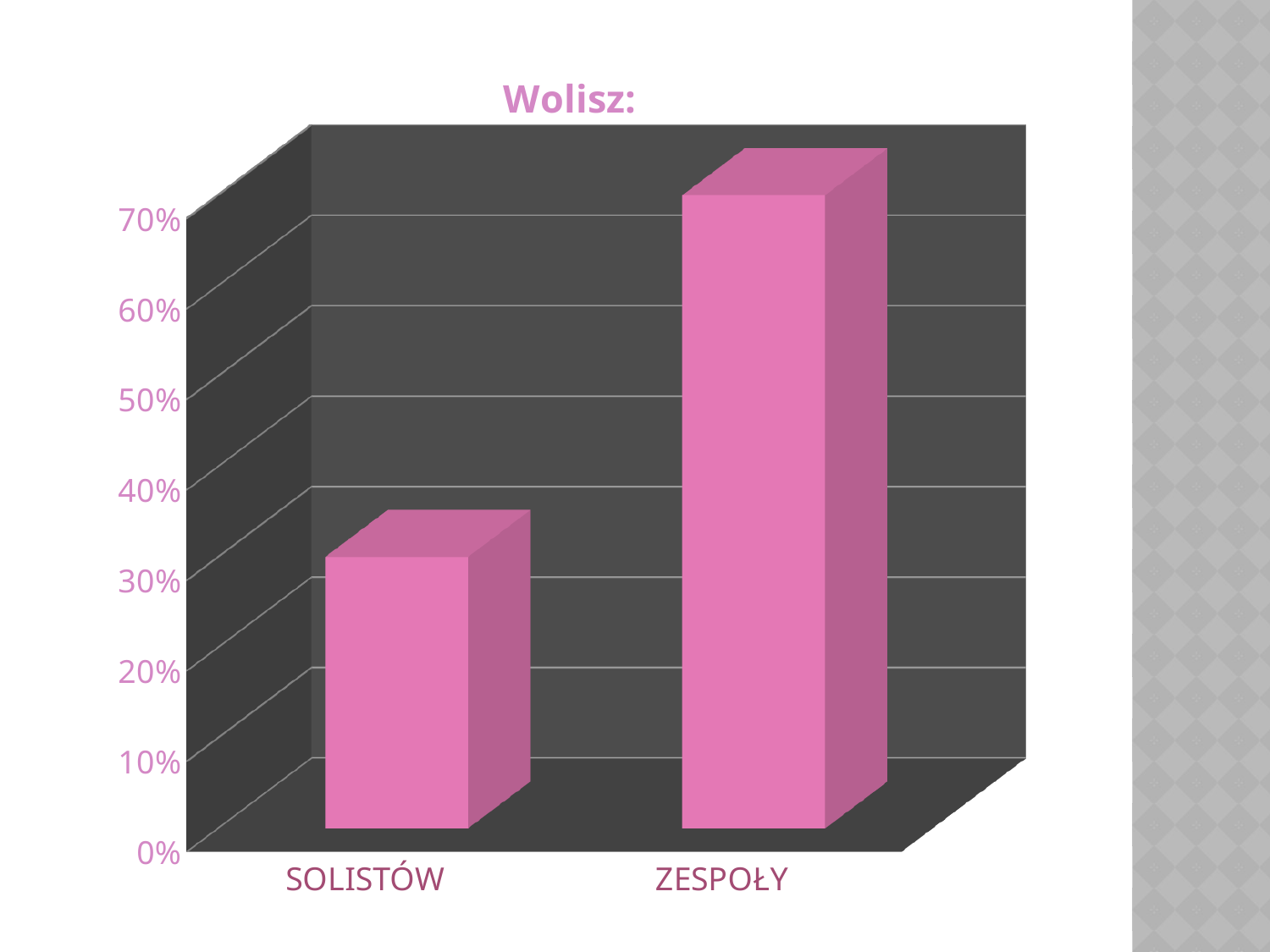
Which is larger, the value for SOLISTÓW or the value for ZESPOŁY? ZESPOŁY What is the highest value labelled on the vertical axis? 70% Is the value for SOLISTÓW greater or less than 20%? greater Is the value for ZESPOŁY greater or less than 60%? greater What kind of chart is shown on the slide? bar chart Which category has the highest value? ZESPOŁY Is the value for ZESPOŁY greater or less than 50%? greater Do the values rise or fall from SOLISTÓW to ZESPOŁY along the x axis? rise How many categories are shown on the x axis of the chart? 2 Which category has the lowest value? SOLISTÓW What is the title of the chart? Wolisz: